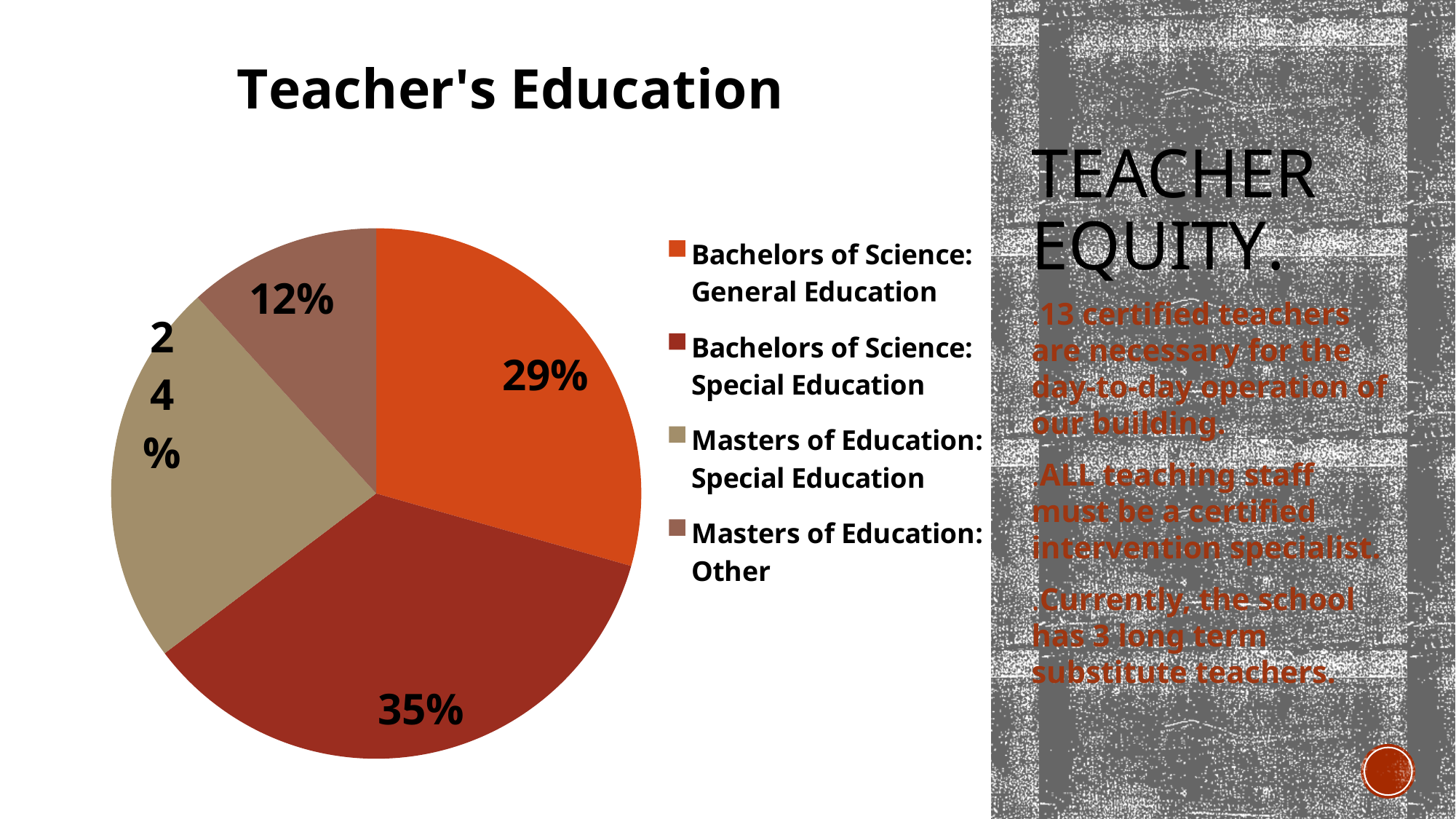
What percentage of teachers have a Bachelors of Science: Special Education? 35% What percentage of teachers have a Masters of Education: Special Education? 24% What is the title of the chart? Teacher's Education What percentage of teachers have a Masters of Education: Other? 12% Which category has the largest share of the pie? Bachelors of Science: Special Education Which category has the smallest share of the pie? Masters of Education: Other What is the combined share of the two Masters of Education categories? 36% How many categories does the pie chart show? 4 Which is larger, the share for Masters of Education: Special Education or Masters of Education: Other? Masters of Education: Special Education What type of chart is shown on the slide? Pie chart What percentage of teachers have a Bachelors of Science: General Education? 29% What is the difference in percentage points between Bachelors of Science: Special Education and Bachelors of Science: General Education? 6